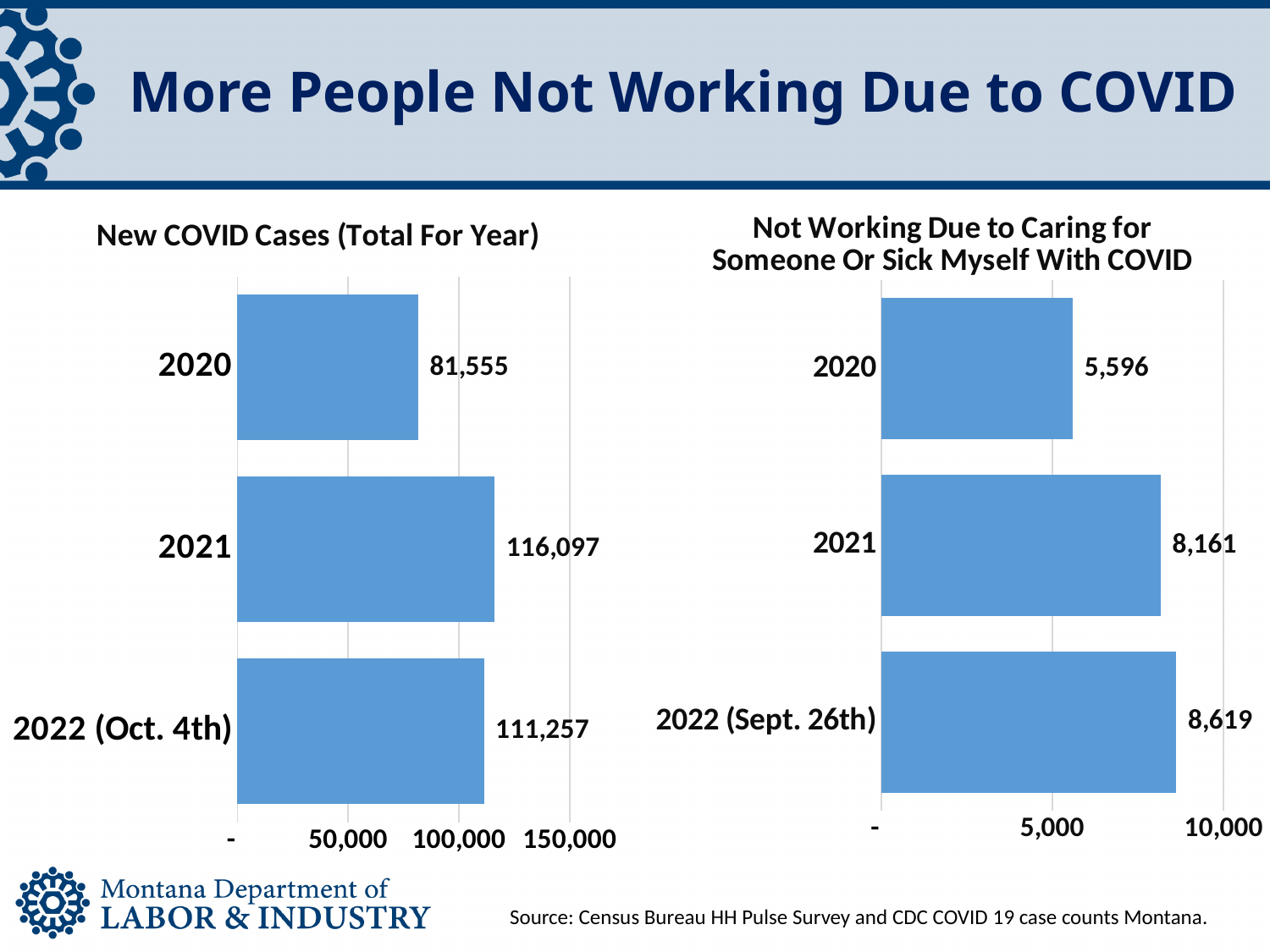
In the 'Not Working Due to Caring for Someone Or Sick Myself With COVID' chart, what is the difference between the 2022 (Sept. 26th) and 2021 values? 458 In the 'New COVID Cases (Total For Year)' chart, what is the value for 2022 (Oct. 4th)? 111,257 In the 'Not Working Due to Caring for Someone Or Sick Myself With COVID' chart, is the value for 2020 greater or less than 5,000? greater What kind of chart is the 'Not Working Due to Caring for Someone Or Sick Myself With COVID' chart? Bar chart How many bars are in the 'New COVID Cases (Total For Year)' chart? 3 In the 'New COVID Cases (Total For Year)' chart, which year has the lowest value? 2020 In the 'Not Working Due to Caring for Someone Or Sick Myself With COVID' chart, what is the value for 2020? 5,596 In the 'Not Working Due to Caring for Someone Or Sick Myself With COVID' chart, which category has the highest value? 2022 (Sept. 26th) In the 'Not Working Due to Caring for Someone Or Sick Myself With COVID' chart, what is the value for 2022 (Sept. 26th)? 8,619 In the 'New COVID Cases (Total For Year)' chart, what is the value for 2021? 116,097 In the 'New COVID Cases (Total For Year)' chart, which year has the highest value? 2021 In the 'New COVID Cases (Total For Year)' chart, what is the difference between the 2021 and 2020 values? 34,542